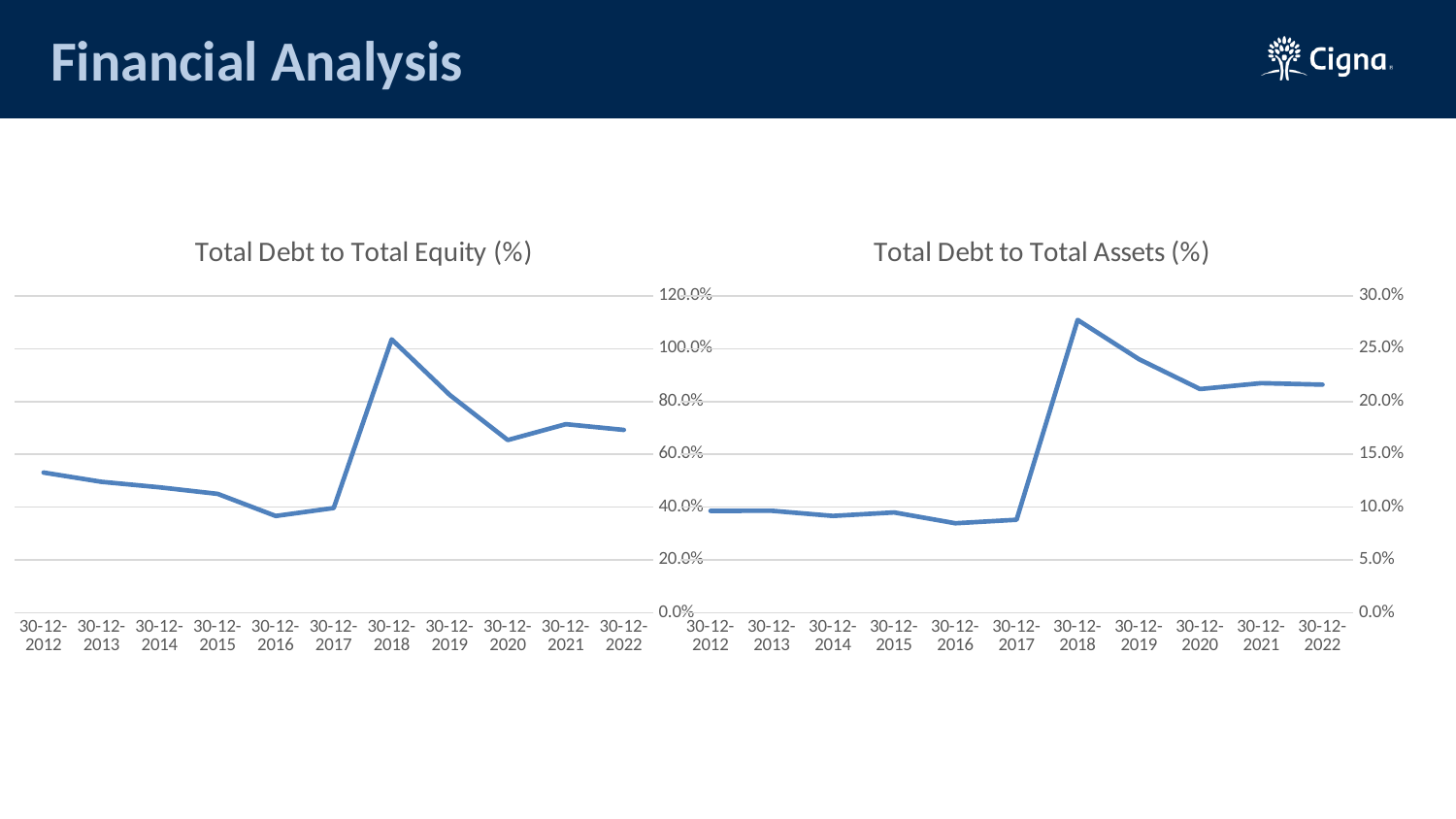
In the 'Total Debt to Total Assets (%)' chart, which date has the lowest value? 30-12-2016 In the 'Total Debt to Total Assets (%)' chart, which date has the highest value? 30-12-2018 In the 'Total Debt to Total Equity (%)' chart, how many data points are plotted? 11 In the 'Total Debt to Total Assets (%)' chart, does the value rise or fall from 30-12-2017 to 30-12-2018? rise In the 'Total Debt to Total Assets (%)' chart, is the value for 30-12-2018 greater or less than 25.0%? greater In the 'Total Debt to Total Equity (%)' chart, which date has the highest value? 30-12-2018 In the 'Total Debt to Total Equity (%)' chart, which is larger, the value for 30-12-2012 or the value for 30-12-2020? 30-12-2020 In the 'Total Debt to Total Equity (%)' chart, is the value for 30-12-2016 greater or less than 40.0%? less In the 'Total Debt to Total Assets (%)' chart, is the value for 30-12-2012 greater or less than 15.0%? less In the 'Total Debt to Total Equity (%)' chart, which date has the lowest value? 30-12-2016 What type of chart is the 'Total Debt to Total Equity (%)' chart? line chart